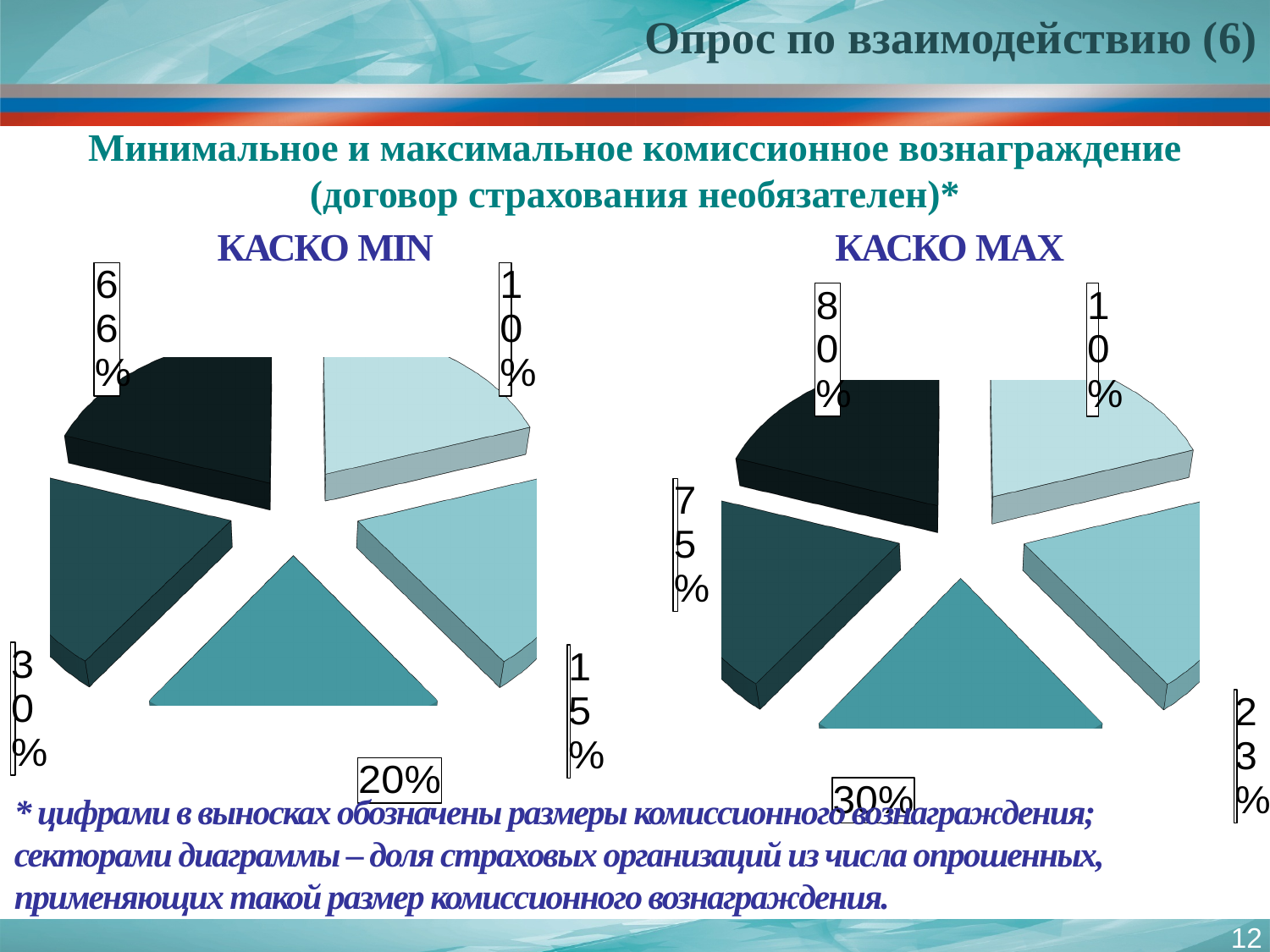
In the КАСКО MAX chart, what is the largest commission size labelled in a callout? 80% In the КАСКО MAX chart, which commission sizes are shown in the slice callouts? 80%, 10%, 23%, 30%, 75% In the КАСКО MIN chart, what is the largest commission size labelled in a callout? 66% What kind of chart is the КАСКО MAX chart? pie chart In the КАСКО MIN chart, what commission size is labelled on the bottom slice? 20% What kind of chart is the КАСКО MIN chart? pie chart In the КАСКО MIN chart, which commission sizes are shown in the slice callouts? 66%, 10%, 15%, 20%, 30% How many slices does the КАСКО MIN pie chart have? 5 How many slices does the КАСКО MAX pie chart have? 5 What is the title of the left pie chart? КАСКО MIN What is the title of the right pie chart? КАСКО MAX